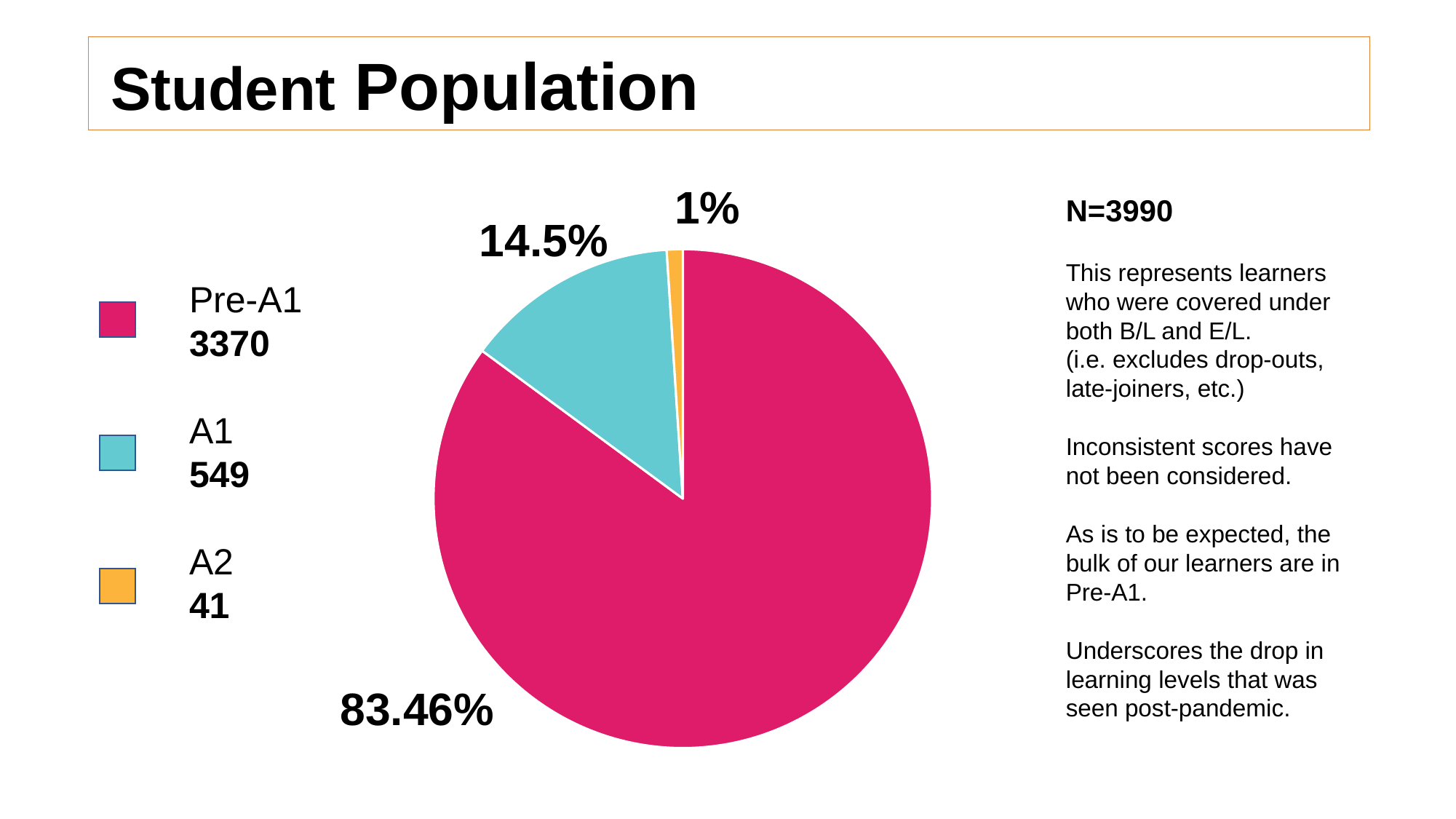
How many slices does the pie chart have? 3 What colour is the Pre-A1 slice in the pie chart? pink What share of the pie does A1 represent? 14.5% Which level has the smallest slice of the pie? A2 What is the number of students in A2? 41 What is the number of students in A1? 549 What kind of chart is shown on the slide? pie chart Which level has the largest slice of the pie? Pre-A1 What share of the pie does Pre-A1 represent? 83.46% What is the difference in student numbers between A1 and A2? 508 How many entries does the legend list? 3 What is the number of students in Pre-A1? 3370